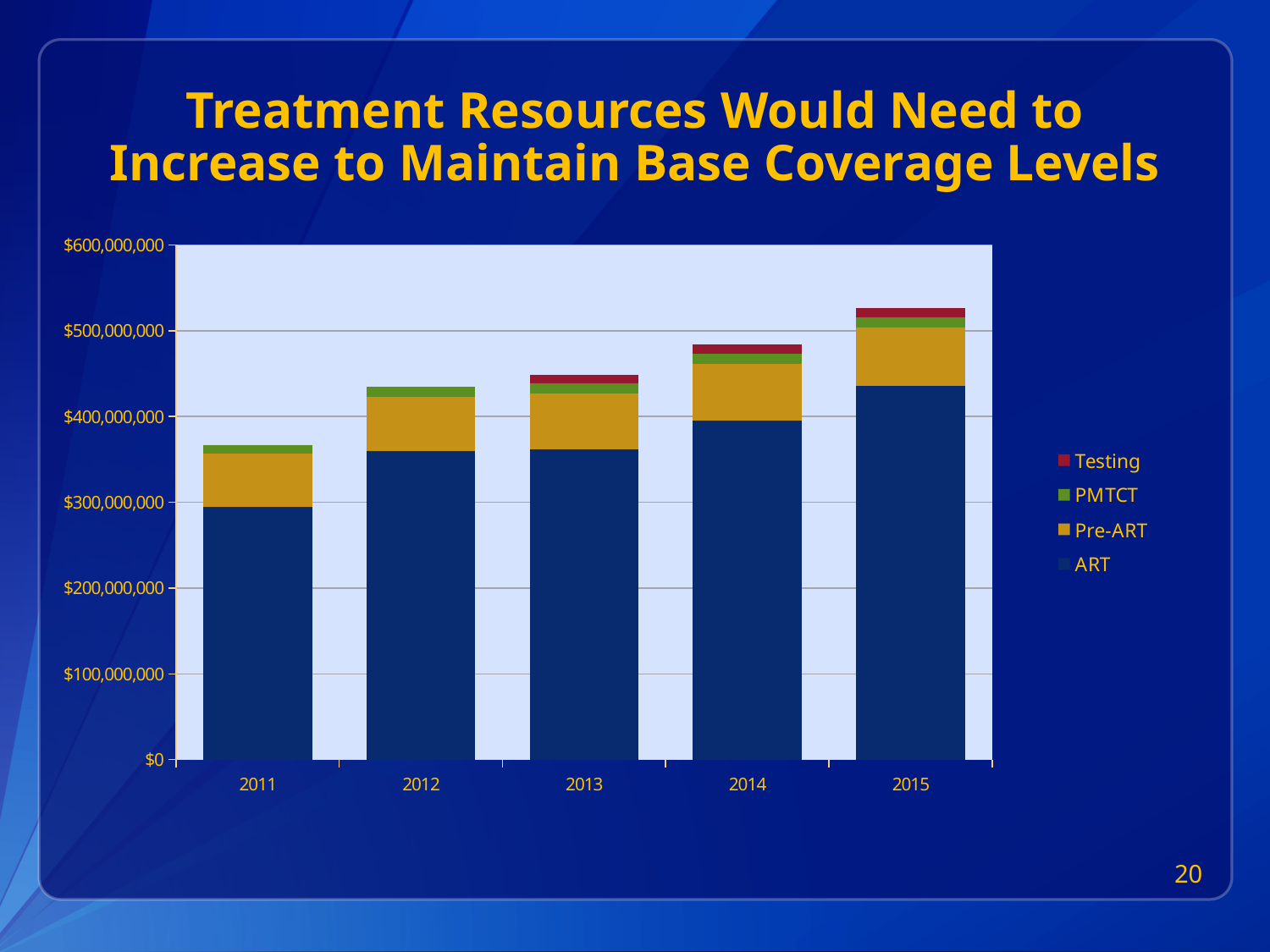
What is the title of the chart's slide? Treatment Resources Would Need to Increase to Maintain Base Coverage Levels Do the total bar heights rise or fall from 2011 to 2015? Rise Which year has the lowest total bar? 2011 Is the ART value for 2015 greater or less than $400,000,000? greater How many years are shown on the x axis of the chart? 5 Which year has the larger total bar, 2012 or 2014? 2014 Which year has the highest total bar? 2015 Is the ART value for 2012 greater or less than $300,000,000? greater What kind of chart is shown on the slide? Stacked bar chart Is the total value for 2015 greater or less than $500,000,000? greater How many series does the chart's legend list? 4